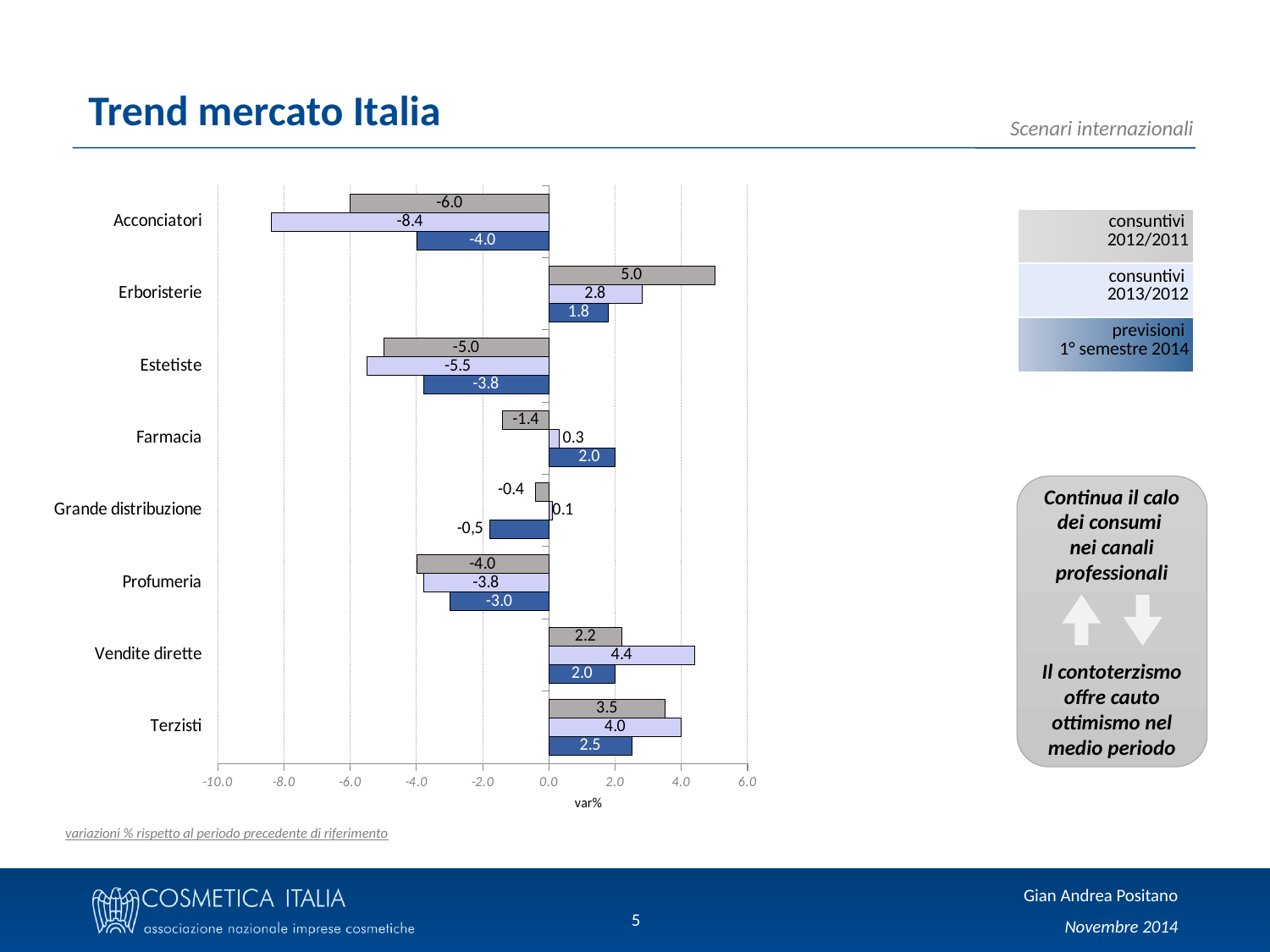
Which is larger for Estetiste: the consuntivi 2012/2011 value or the previsioni 1° semestre 2014 value? previsioni 1° semestre 2014 How many series does the legend list? 3 What is the consuntivi 2013/2012 value for Vendite dirette? 4.4 What kind of chart is shown on the slide? Bar chart What is the difference between the consuntivi 2013/2012 value and the previsioni 1° semestre 2014 value for Terzisti? 1.5 What is the consuntivi 2012/2011 value for Erboristerie? 5.0 How many categories are shown on the chart? 8 Which category has the lowest consuntivi 2013/2012 value? Acconciatori What is the previsioni 1° semestre 2014 value for Farmacia? 2.0 What is the consuntivi 2013/2012 value for Acconciatori? -8.4 What is the label of the x axis? var% Which category has the highest consuntivi 2012/2011 value? Erboristerie